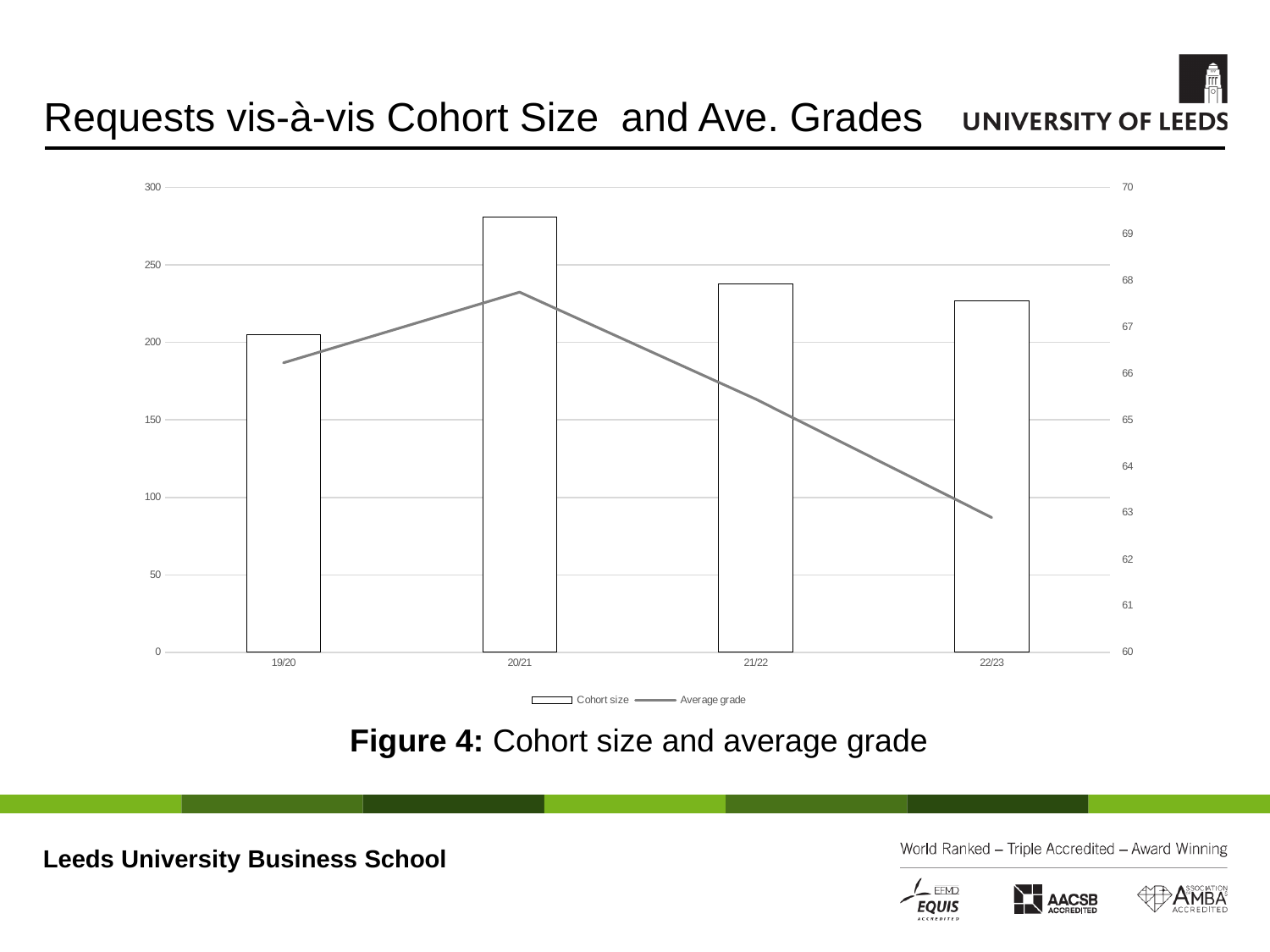
Is the cohort size for 21/22 greater or less than 250? less Which year has the smallest cohort size? 19/20 How many academic years are shown on the x axis? 4 Which year has the lowest average grade? 22/23 Which year has the highest average grade? 20/21 Is the average grade for 22/23 greater or less than 64? less Is the cohort size for 20/21 greater or less than 250? greater Does the average grade rise or fall from 20/21 to 22/23? It falls Which year has the largest cohort size? 20/21 How many series does the legend list? 2 What kind of chart is shown on the slide? A combined bar and line chart What are the two series named in the legend? Cohort size and Average grade